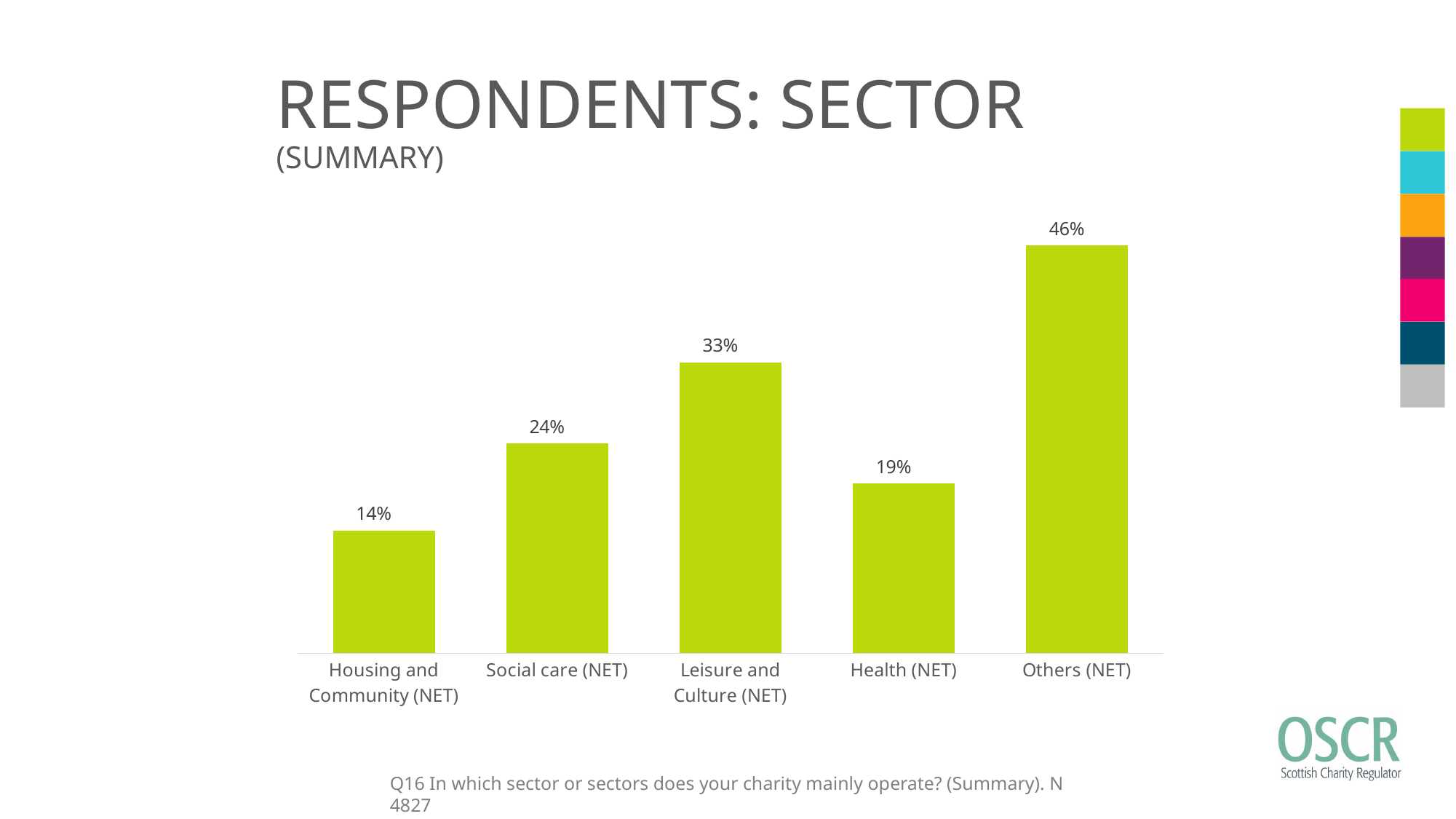
Which category has the lowest value? Housing and Community (NET) What is the value for Social care (NET)? 24% What is the value for Housing and Community (NET)? 14% What kind of chart is shown on the slide? Bar chart What is the value for Health (NET)? 19% What is the difference between the values for Others (NET) and Leisure and Culture (NET)? 13% What is the difference between the values for Social care (NET) and Health (NET)? 5% What colour are the bars in the chart? Green What is the value for Leisure and Culture (NET)? 33% Which category has the highest value? Others (NET) How many categories are shown on the chart? 5 Which is larger, the value for Social care (NET) or the value for Health (NET)? Social care (NET)